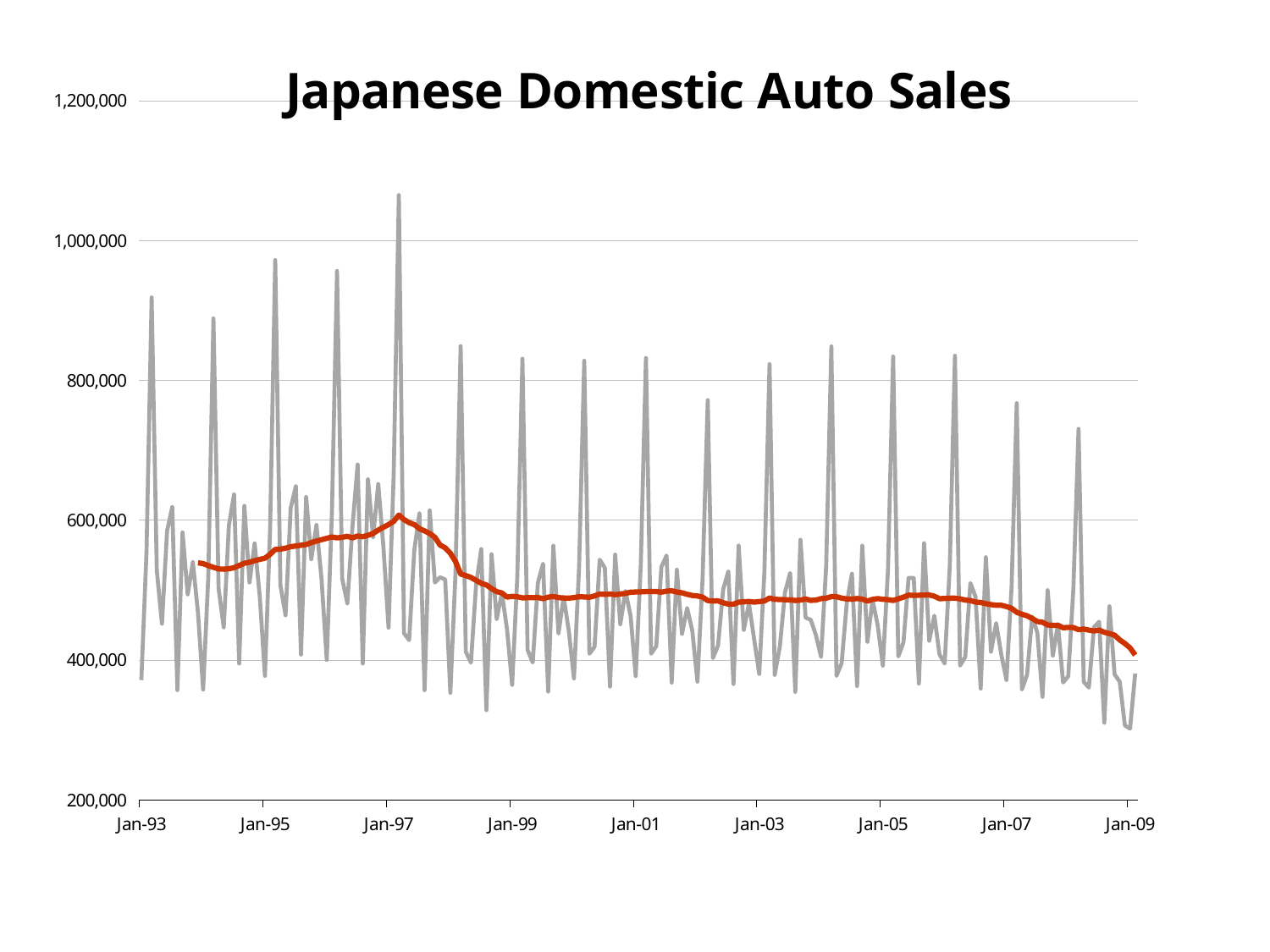
What kind of chart is shown on the slide? line chart Is the peak of the red line, near Jan-97, greater or less than 800,000? less What is the last label on the x axis? Jan-09 What is the first label on the x axis? Jan-93 Is the highest peak of the gray line, near Jan-97, greater or less than 1,000,000? greater How many labelled tick marks are there on the x axis? 9 Which is higher: the red line's value near Jan-97 or its value near Jan-09? near Jan-97 Does the red line rise or fall between Jan-97 and Jan-09? fall What is the title of the chart? Japanese Domestic Auto Sales How many lines are plotted on the chart? 2 Is the value of the red line at its end, near Jan-09, greater or less than 600,000? less